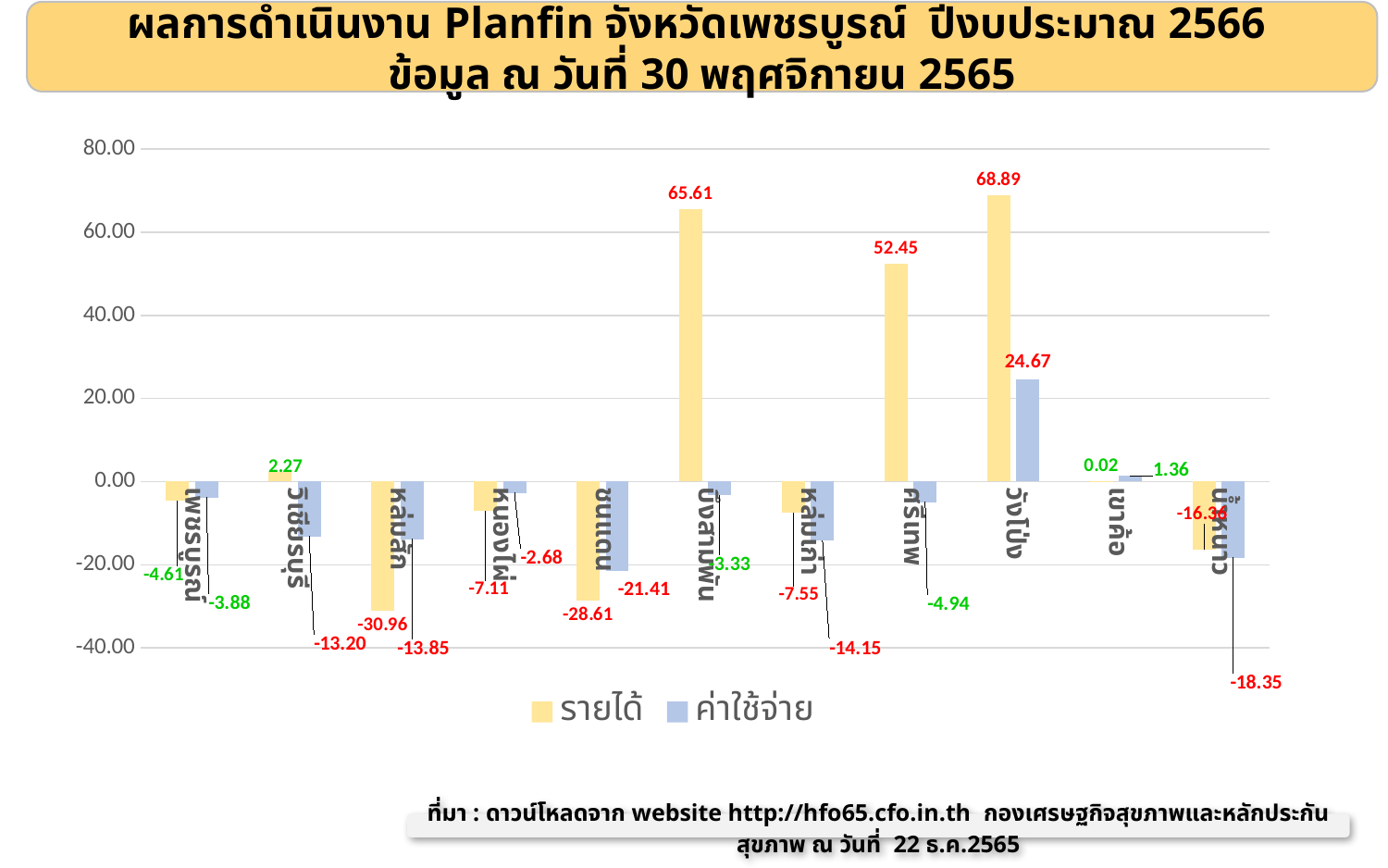
What is the difference between the รายได้ values of วังโป่ง and บึงสามพัน? 3.28 What is the ค่าใช้จ่าย value for วังโป่ง? 24.67 How many categories are shown on the x axis? 11 Which category has the highest ค่าใช้จ่าย value? วังโป่ง Which category has the highest รายได้ value? วังโป่ง Which has the larger รายได้ value, บึงสามพัน or ศรีเทพ? บึงสามพัน What is the รายได้ value for ศรีเทพ? 52.45 What is the รายได้ value for วังโป่ง? 68.89 Which category has the lowest รายได้ value? หล่มสัก What kind of chart is shown on the slide? Bar chart What is the ค่าใช้จ่าย value for ชนแดน? -21.41 How many series does the legend list? 2